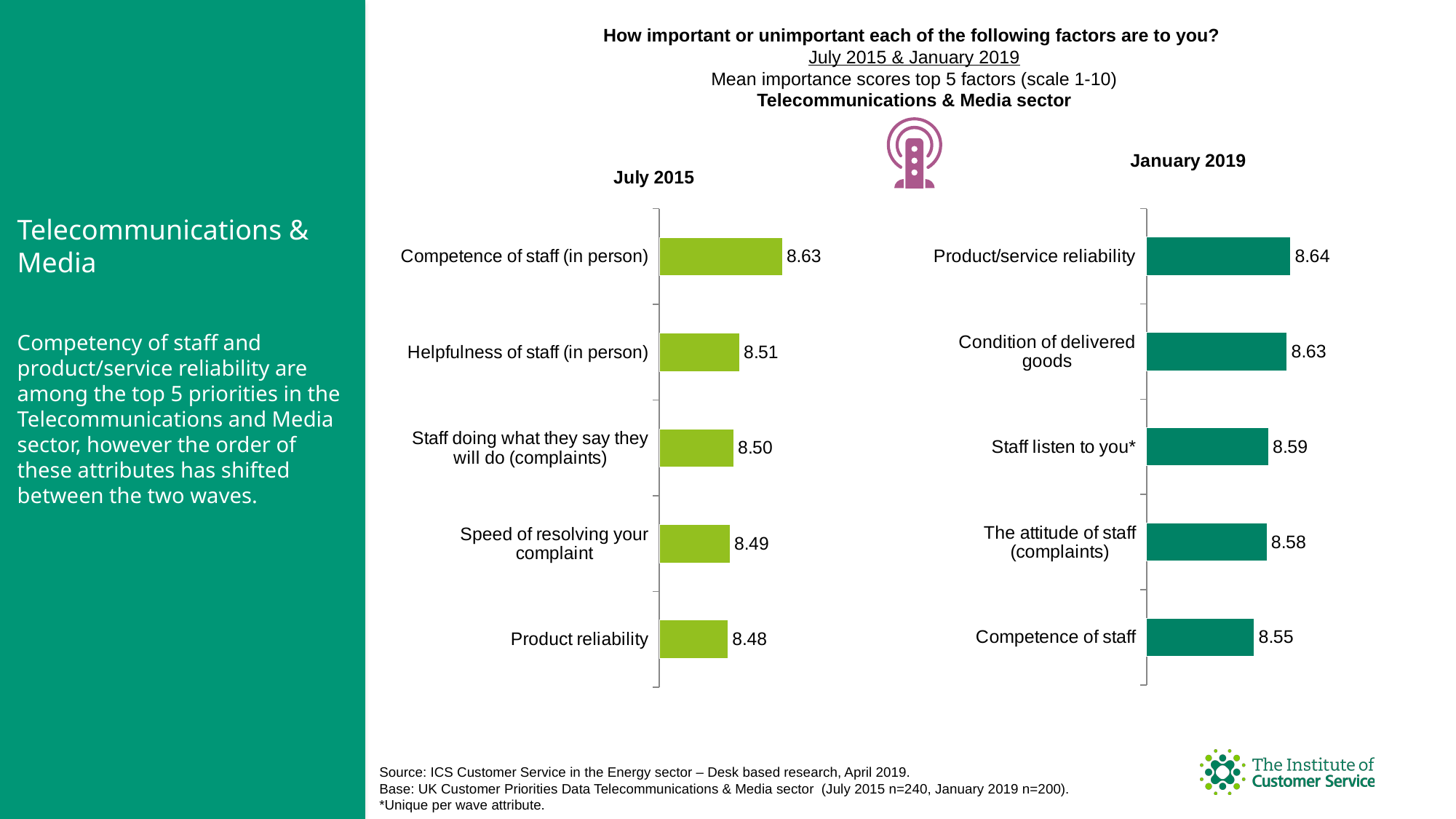
In the January 2019 chart, what is the difference between the scores for Product/service reliability and Competence of staff? 0.09 In the January 2019 chart, what is the mean importance score for Staff listen to you*? 8.59 In the July 2015 chart, what is the score for Product reliability? 8.48 How many factors are shown in the July 2015 chart? 5 In the July 2015 chart, which factor has the lowest score? Product reliability What colour are the bars in the July 2015 chart? Light green In the July 2015 chart, what is the mean importance score for Competence of staff (in person)? 8.63 In the January 2019 chart, which factor has the lowest score? Competence of staff What type of chart is used to show the January 2019 scores? Bar chart In the January 2019 chart, which factor has the highest score? Product/service reliability In the July 2015 chart, what is the difference between the scores for Competence of staff (in person) and Helpfulness of staff (in person)? 0.12 Which is larger: the July 2015 score for Speed of resolving your complaint or the January 2019 score for The attitude of staff (complaints)? The attitude of staff (complaints)